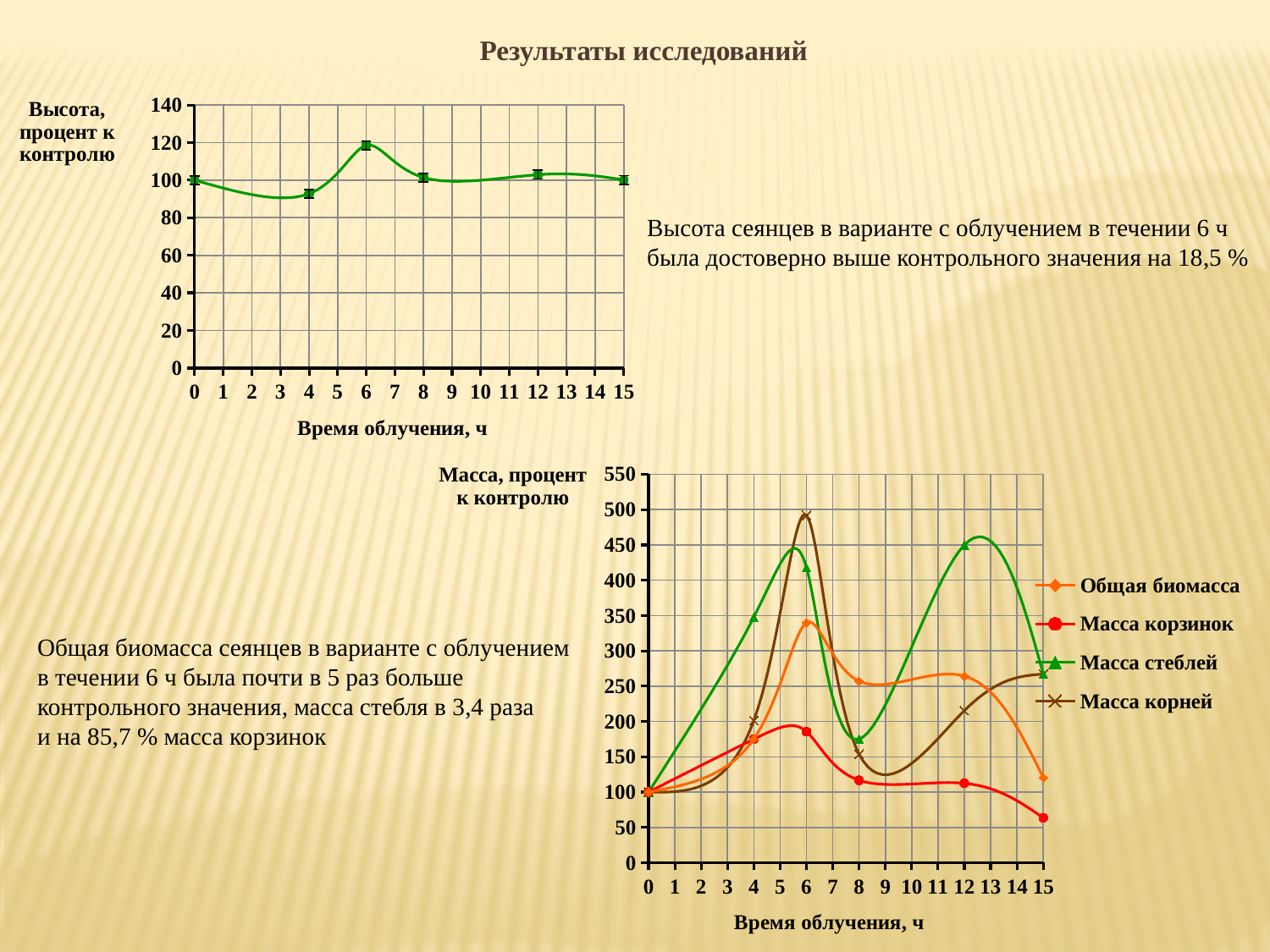
In the top chart (Высота, процент к контролю), is the value at 6 h greater or less than 100? greater In the bottom chart (Масса, процент к контролю), which series has the highest value at 6 h? Масса корней In the bottom chart (Масса, процент к контролю), which is larger at 8 h: Общая биомасса or Масса корзинок? Общая биомасса In the top chart (Высота, процент к контролю), how many data points are plotted? 6 In the top chart (Высота, процент к контролю), at which irradiation time is the height lowest? 4 In the bottom chart (Масса, процент к контролю), which series has the highest value at 12 h? Масса стеблей In the top chart (Высота, процент к контролю), is the value at 4 h greater or less than 100? less What is the x-axis title of the bottom chart (Масса, процент к контролю)? Время облучения, ч In the bottom chart (Масса, процент к контролю), is the value of Масса корзинок at 15 h greater or less than 100? less In the top chart (Высота, процент к контролю), at which irradiation time is the height highest? 6 What kind of chart is the top chart (Высота, процент к контролю)? line chart How many series does the legend of the bottom chart (Масса, процент к контролю) list? 4